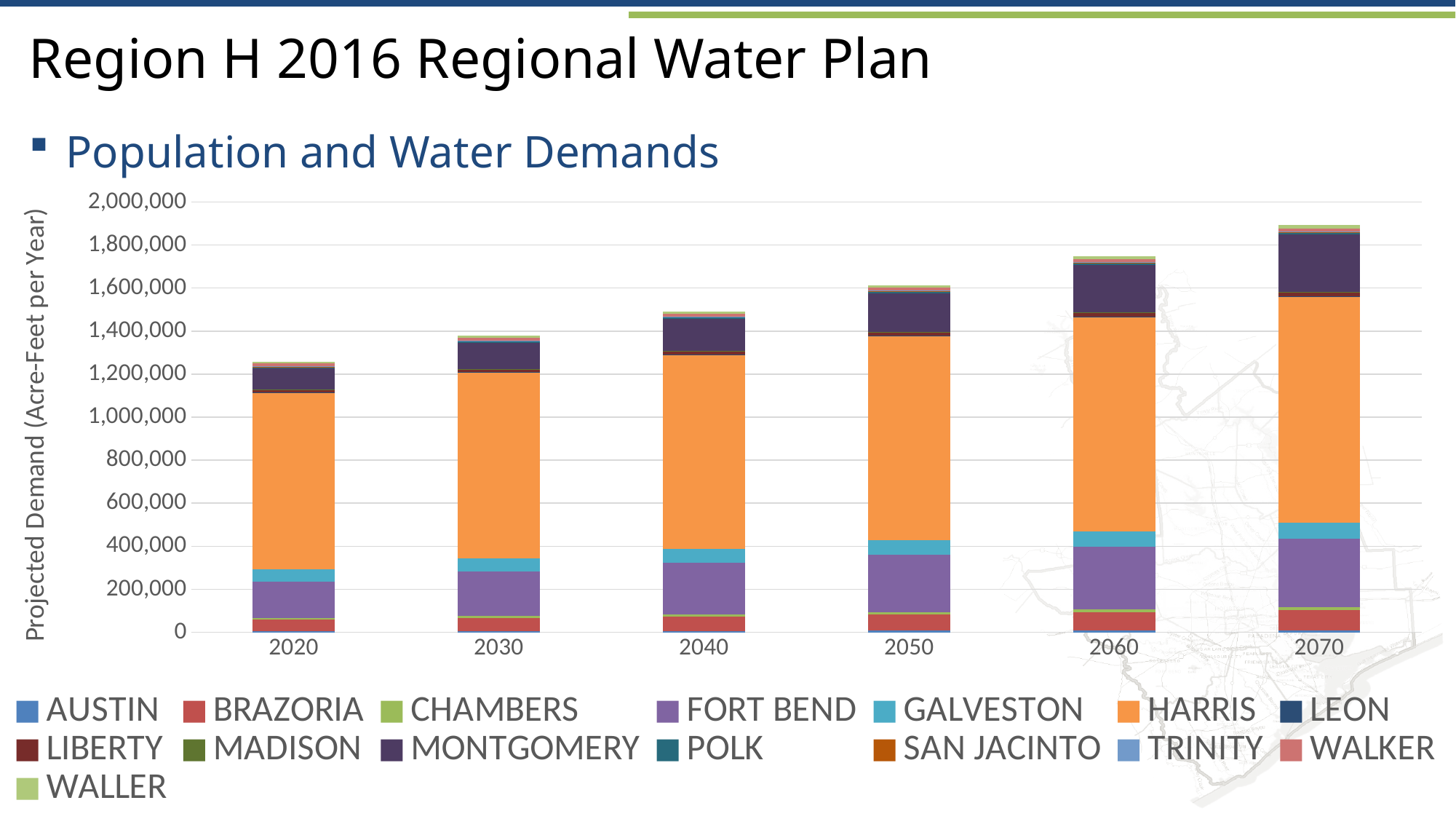
Is the total projected demand for 2060 greater or less than 1,600,000? greater Is the total projected demand for 2020 greater or less than 1,400,000? less How many series does the legend list? 15 In 2070, which segment is larger, HARRIS or MONTGOMERY? HARRIS Which year has the lowest total projected demand? 2020 Do the total projected demands rise or fall from 2020 to 2070? Rise Which year has the highest total projected demand? 2070 Is the total projected demand for 2070 greater or less than 1,800,000? greater Which is larger, the total projected demand for 2030 or for 2050? 2050 What kind of chart is shown on the slide? Stacked bar chart What is the label on the vertical axis? Projected Demand (Acre-Feet per Year) How many years (categories) are shown along the x axis? 6